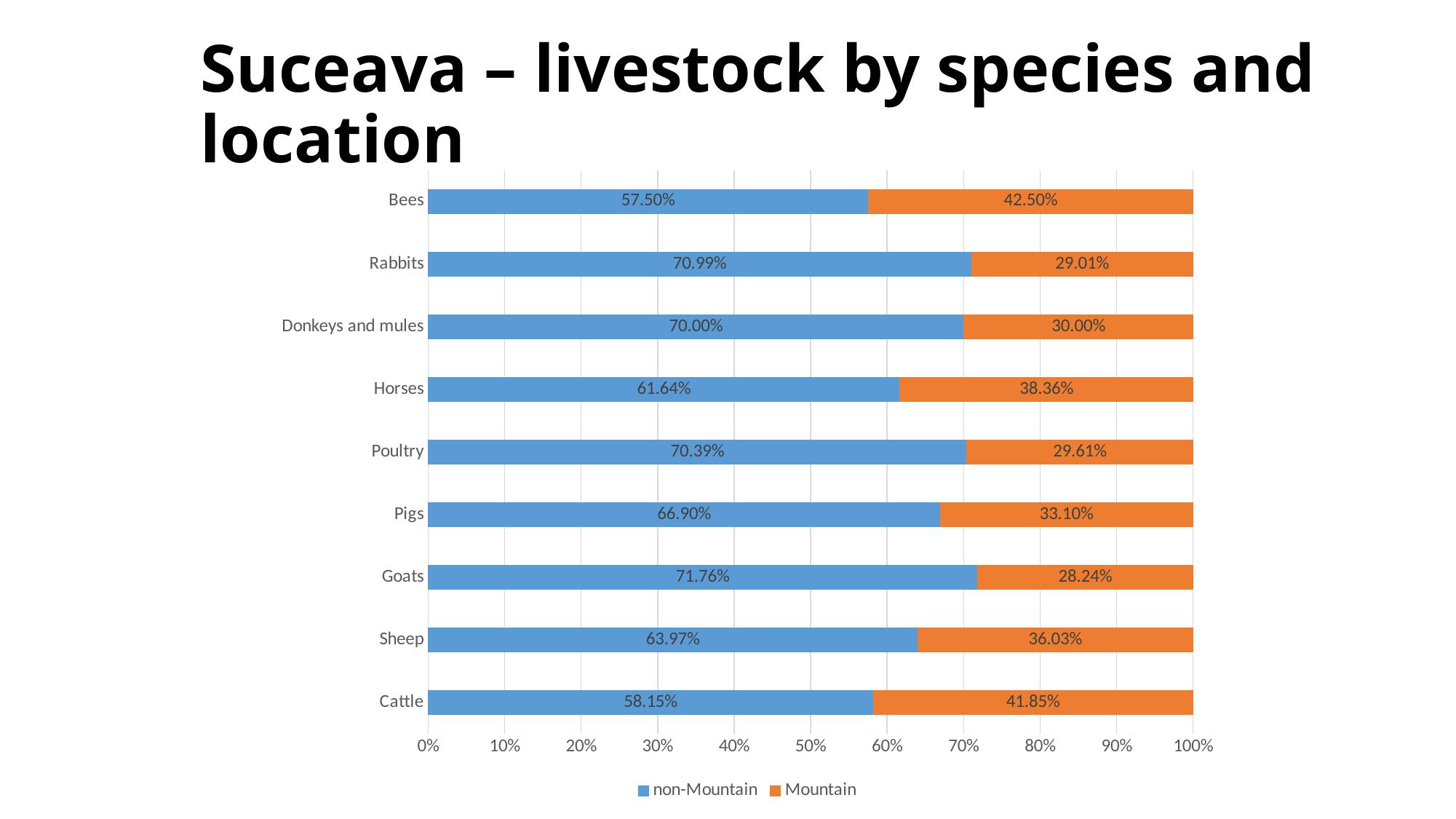
Which species has the highest non-Mountain share? Goats Which species has the lowest non-Mountain share? Bees What is the difference between the non-Mountain and Mountain shares for Cattle? 16.30% What kind of chart is shown on the slide? Stacked bar chart Which has a larger Mountain share, Horses or Pigs? Horses Which species has the highest Mountain share? Bees What is the Mountain share for Donkeys and mules? 30.00% How many species are shown on the chart? 9 What is the total of the stacked bar for Poultry? 100.00% What is the Mountain share for Sheep? 36.03% How many series does the legend list? 2 What is the non-Mountain share for Bees? 57.50%